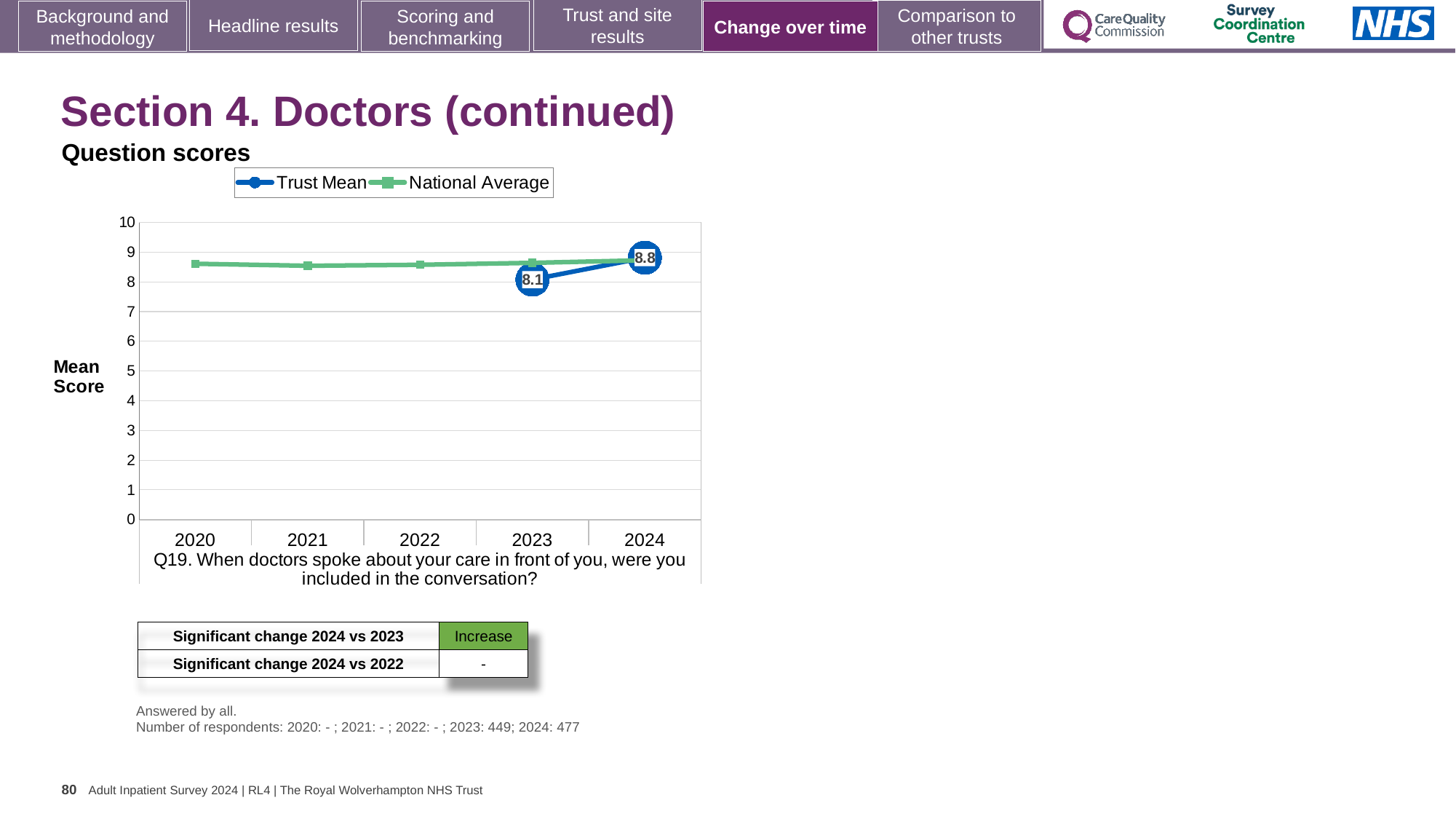
In which year is the Trust Mean score lowest? 2023 How many series does the chart legend list? 2 Is the National Average for 2020 greater or less than 8? greater What kind of chart is shown on the slide? line chart What is the Trust Mean score for 2023? 8.1 Did the Trust Mean score rise or fall from 2023 to 2024? rise How many years are shown on the x axis of the chart? 5 By how much did the Trust Mean score change from 2023 to 2024? 0.7 In 2023, which is higher: the Trust Mean or the National Average? National Average What is the Trust Mean score for 2024? 8.8 In which year is the Trust Mean score highest? 2024 Is the National Average for 2022 greater or less than 9? less